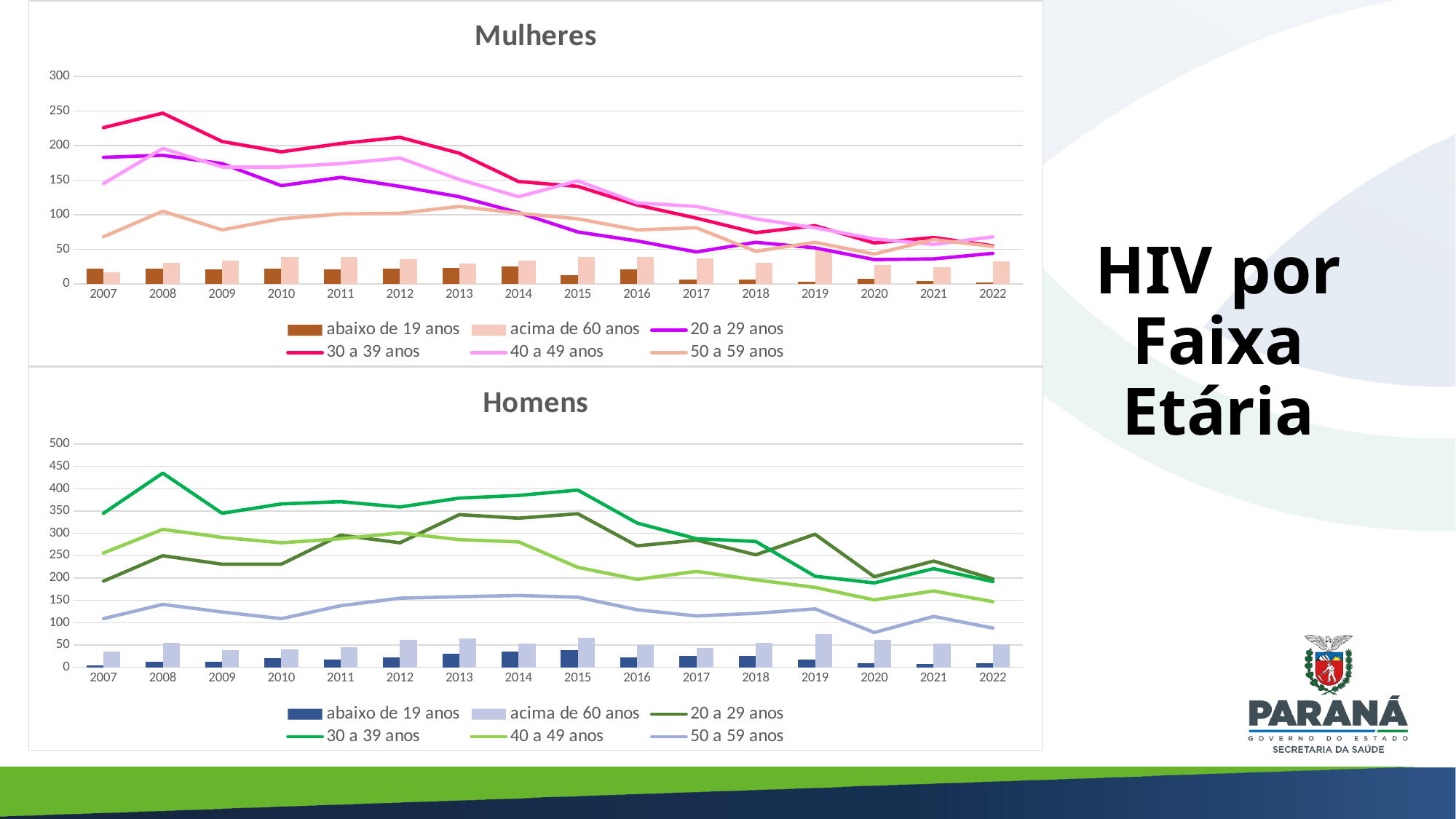
In the Mulheres chart, is the value for 30 a 39 anos in 2008 greater or less than 200? greater In the Homens chart, which is larger in 2019: 20 a 29 anos or 30 a 39 anos? 20 a 29 anos How many series does the legend of the Mulheres chart list? 6 In the Mulheres chart, in which year does the 30 a 39 anos series reach its highest value? 2008 In the Mulheres chart, is the value for 20 a 29 anos in 2022 greater or less than 100? less In the Mulheres chart, which series has the highest value in 2008? 30 a 39 anos How many years are shown on the x axis of the Homens chart? 16 In the Mulheres chart, is the 30 a 39 anos series drawn as bars or as a line? line In the Homens chart, in which year does the 30 a 39 anos series reach its highest value? 2008 In the Mulheres chart, does the 30 a 39 anos series rise or fall from 2012 to 2022? fall In the Homens chart, is the value for 30 a 39 anos in 2008 greater or less than 400? greater What is the title of the lower chart on the slide? Homens